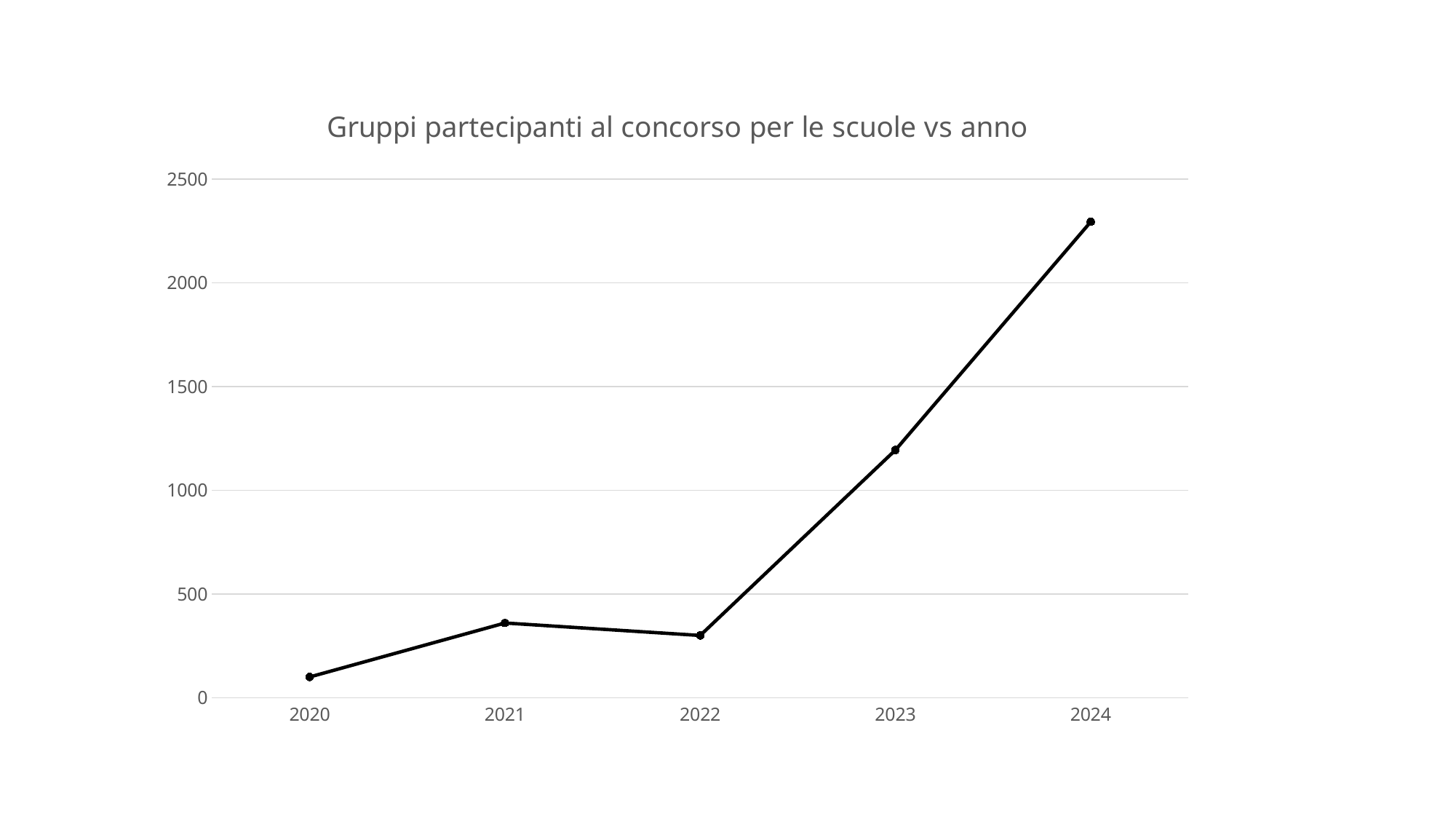
Overall, do the values rise or fall from 2020 to 2024? rise Is the value for 2023 greater or less than 1500? less What type of chart is shown on the slide? line chart Is the value for 2023 greater or less than 1000? greater What is the title of the chart? Gruppi partecipanti al concorso per le scuole vs anno Which year has a larger value, 2022 or 2023? 2023 Which year has the highest number of participating groups? 2024 How many years are plotted on the x axis? 5 Is the value for 2020 greater or less than 500? less Which year has the lowest number of participating groups? 2020